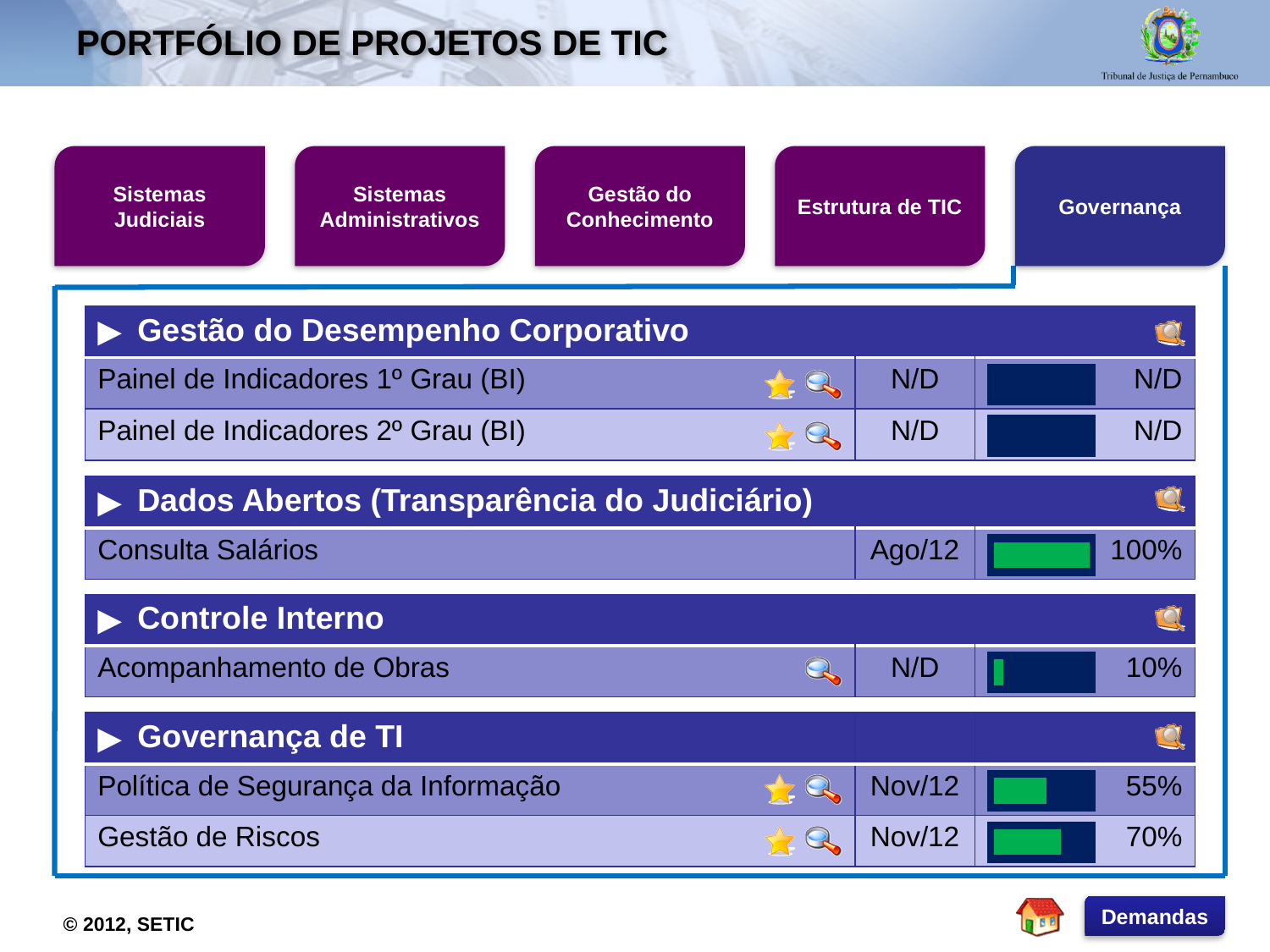
Which has a higher completion percentage, Gestão de Riscos or Acompanhamento de Obras? Gestão de Riscos What completion percentage is shown for Consulta Salários? 100% Under which group heading is Acompanhamento de Obras listed? Controle Interno What value is shown in the progress column for Painel de Indicadores 1º Grau (BI)? N/D What date is shown for Consulta Salários? Ago/12 What completion percentage is shown for Política de Segurança da Informação? 55% Which project has the lowest completion percentage among those with a percentage shown? Acompanhamento de Obras Which project has the highest completion percentage? Consulta Salários What is the difference between the completion percentages of Gestão de Riscos and Política de Segurança da Informação? 15% What completion percentage is shown for Gestão de Riscos? 70% How many projects are listed in the table? 6 What completion percentage is shown for Acompanhamento de Obras? 10%